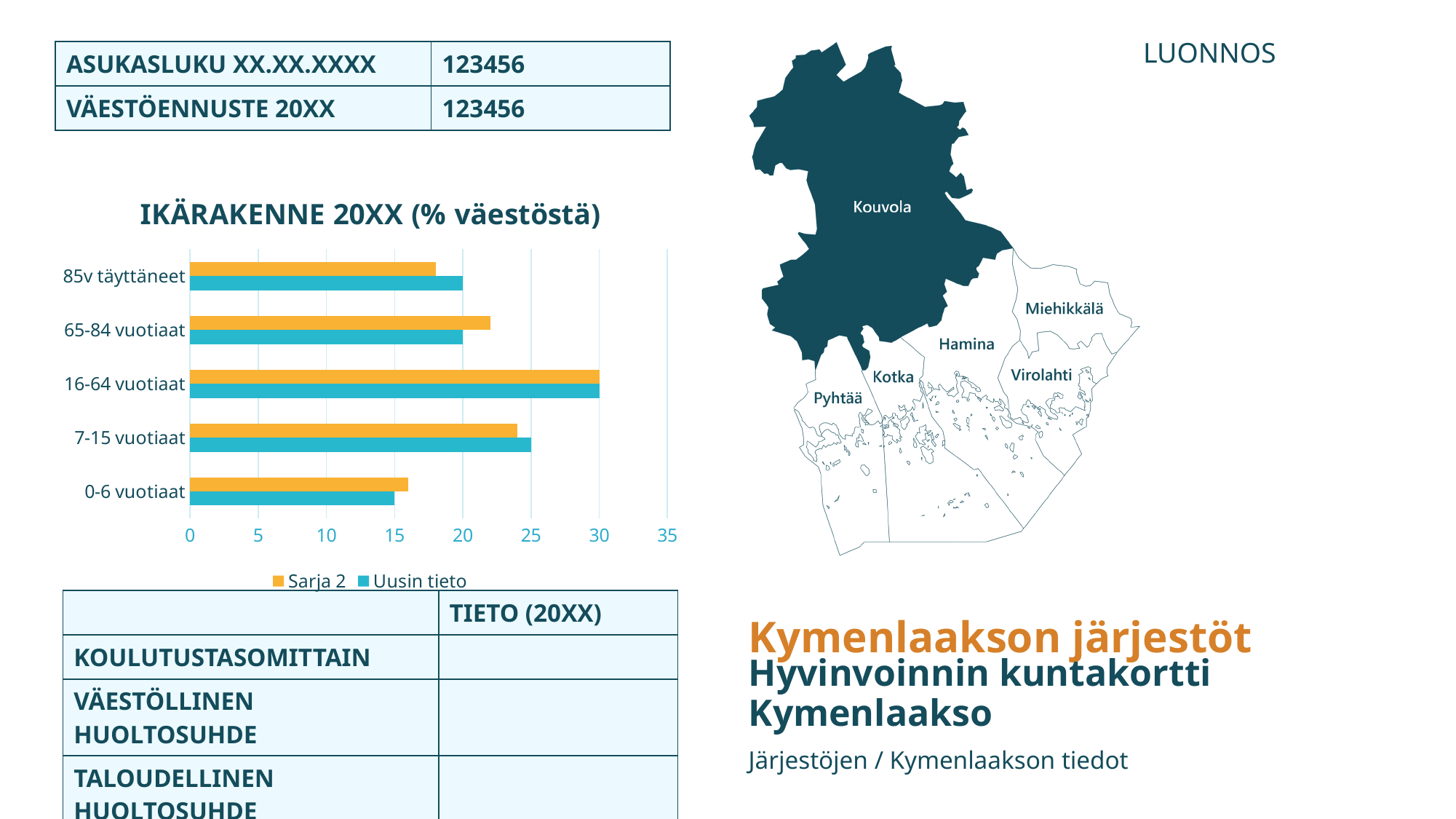
What kind of chart is shown under the title "IKÄRAKENNE 20XX (% väestöstä)"? bar chart Which age category has the lowest value for Uusin tieto in the IKÄRAKENNE chart? 0-6 vuotiaat In the IKÄRAKENNE chart, is the Sarja 2 value for 85v täyttäneet greater or less than 20? less Which age category has the highest value for Uusin tieto in the IKÄRAKENNE chart? 16-64 vuotiaat In the IKÄRAKENNE chart, for 85v täyttäneet, which series has the larger value, Sarja 2 or Uusin tieto? Uusin tieto Which age category has the lowest value for Sarja 2 in the IKÄRAKENNE chart? 0-6 vuotiaat In the IKÄRAKENNE chart, for 65-84 vuotiaat, which series has the larger value, Sarja 2 or Uusin tieto? Sarja 2 What are the two series named in the legend of the IKÄRAKENNE chart? Sarja 2 and Uusin tieto How many age categories are plotted in the IKÄRAKENNE chart? 5 How many series does the legend of the IKÄRAKENNE chart list? 2 In the IKÄRAKENNE chart, what is the Uusin tieto value for 16-64 vuotiaat? 30 In the IKÄRAKENNE chart, is the Sarja 2 value for 65-84 vuotiaat greater or less than 20? greater